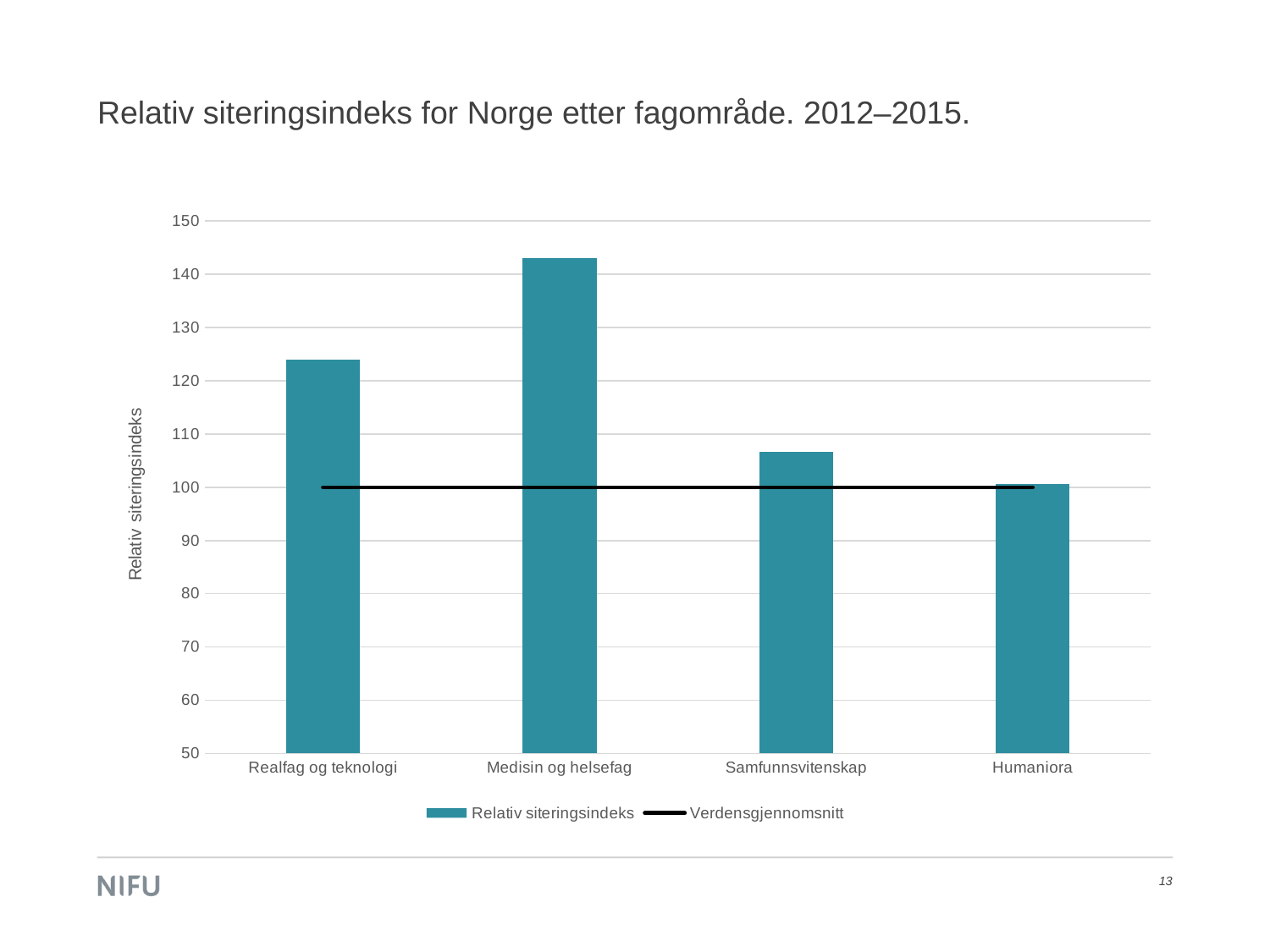
Which subject area has the highest relative citation index? Medisin og helsefag Which subject area has the lowest relative citation index? Humaniora What is the label of the y axis? Relativ siteringsindeks At what value does the Verdensgjennomsnitt line sit on the y axis? 100 Which has a higher relative citation index, Realfag og teknologi or Samfunnsvitenskap? Realfag og teknologi What kind of chart is shown on the slide? bar and line chart How many subject areas (categories) are shown on the x axis? 4 How many series does the legend list? 2 Is the value for Medisin og helsefag greater or less than 140? greater What is the title of the chart on the slide? Relativ siteringsindeks for Norge etter fagområde. 2012–2015. Is the value for Realfag og teknologi greater or less than 120? greater Is the value for Samfunnsvitenskap greater or less than 110? less